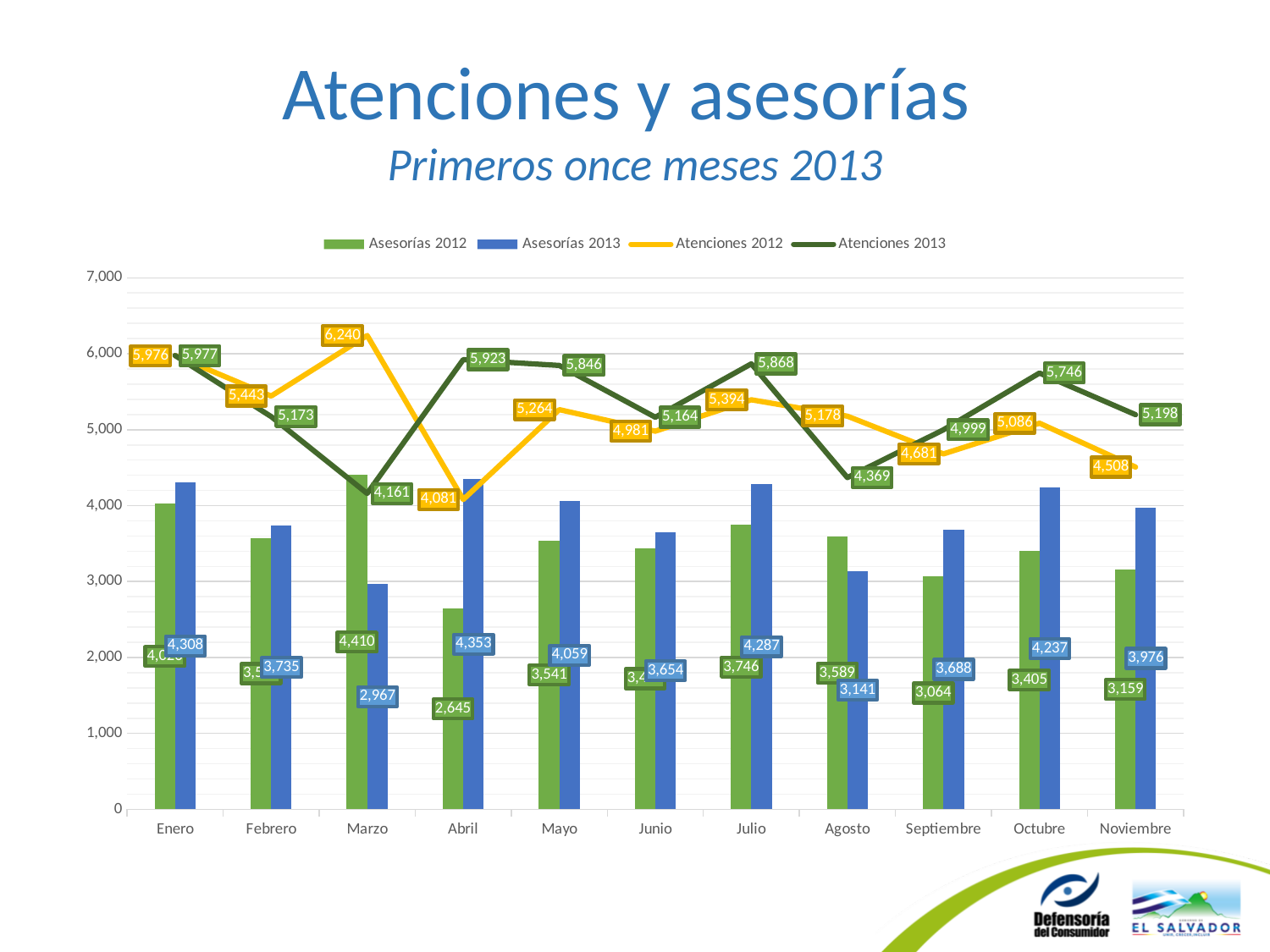
What is the value of Asesorías 2013 in Abril? 4,353 In which month is Asesorías 2012 lowest? Abril How many months are shown on the x axis? 11 How many series does the legend list? 4 What is the difference between Atenciones 2013 in Abril and in Marzo? 1,762 In which month is Atenciones 2012 highest? Marzo What is the value of Atenciones 2012 in Marzo? 6,240 What is the value of Atenciones 2013 in Octubre? 5,746 Is the value for Asesorías 2012 in Febrero greater or less than 4,000? less In which month is Atenciones 2013 lowest? Marzo In Agosto, which is larger: Atenciones 2012 or Atenciones 2013? Atenciones 2012 In Marzo, how much larger is Asesorías 2012 than Asesorías 2013? 1,443